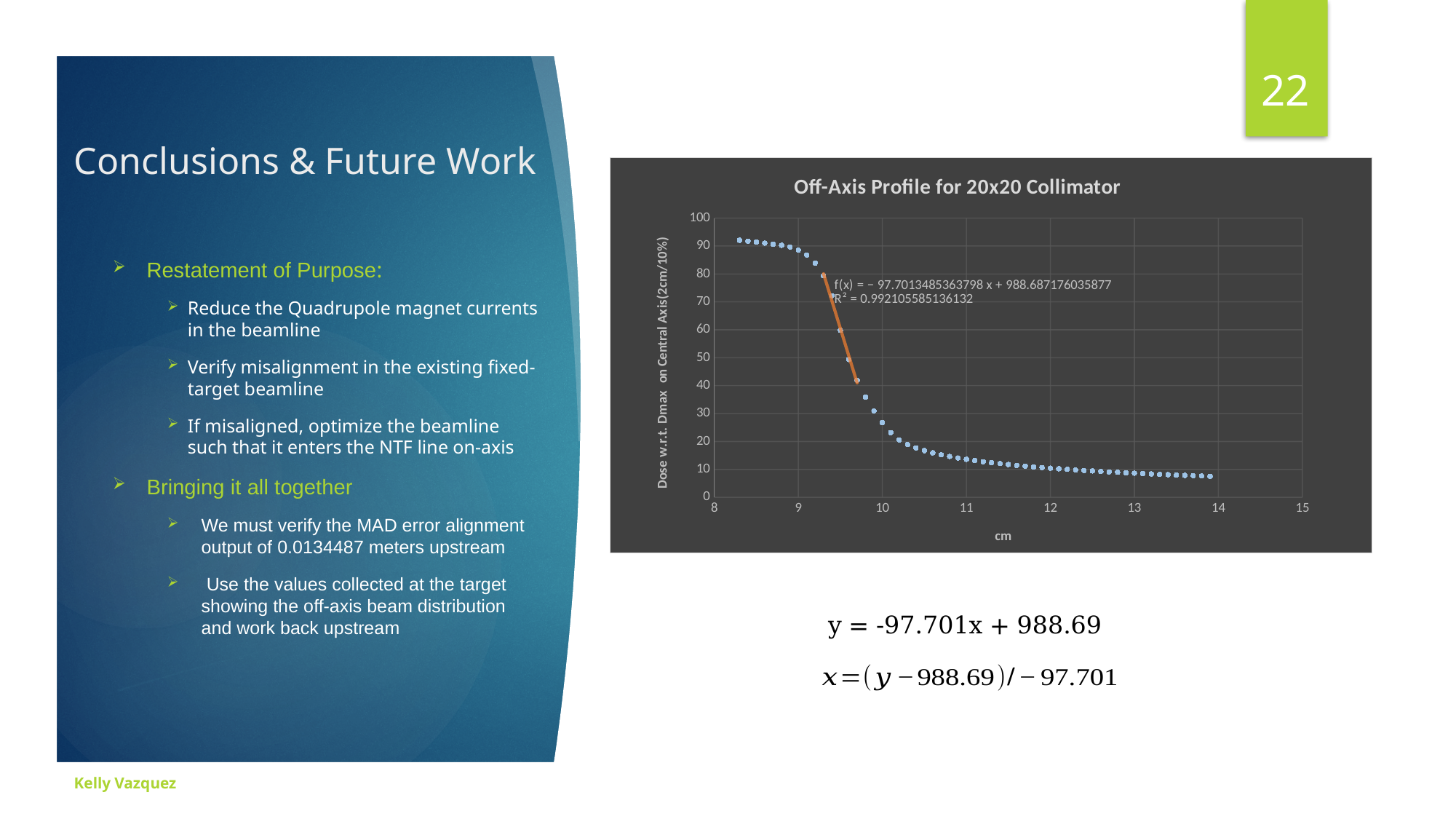
What is the highest value shown on the y axis of the chart? 100 Do the plotted values rise or fall as the x axis increases from 8 to 14 cm? fall What kind of chart is shown on the slide? scatter chart What is the R² value printed for the trendline on the chart? 0.992105585136132 Is the plotted value at 13 cm greater or less than 20? less Is the plotted value at 11 cm greater or less than 30? less What is the trendline equation printed on the chart? f(x) = −97.7013485363798 x + 988.687176035877 Is the plotted value at 8.5 cm greater or less than 80? greater What is the title of the chart? Off-Axis Profile for 20x20 Collimator What is the label of the x axis of the chart? cm